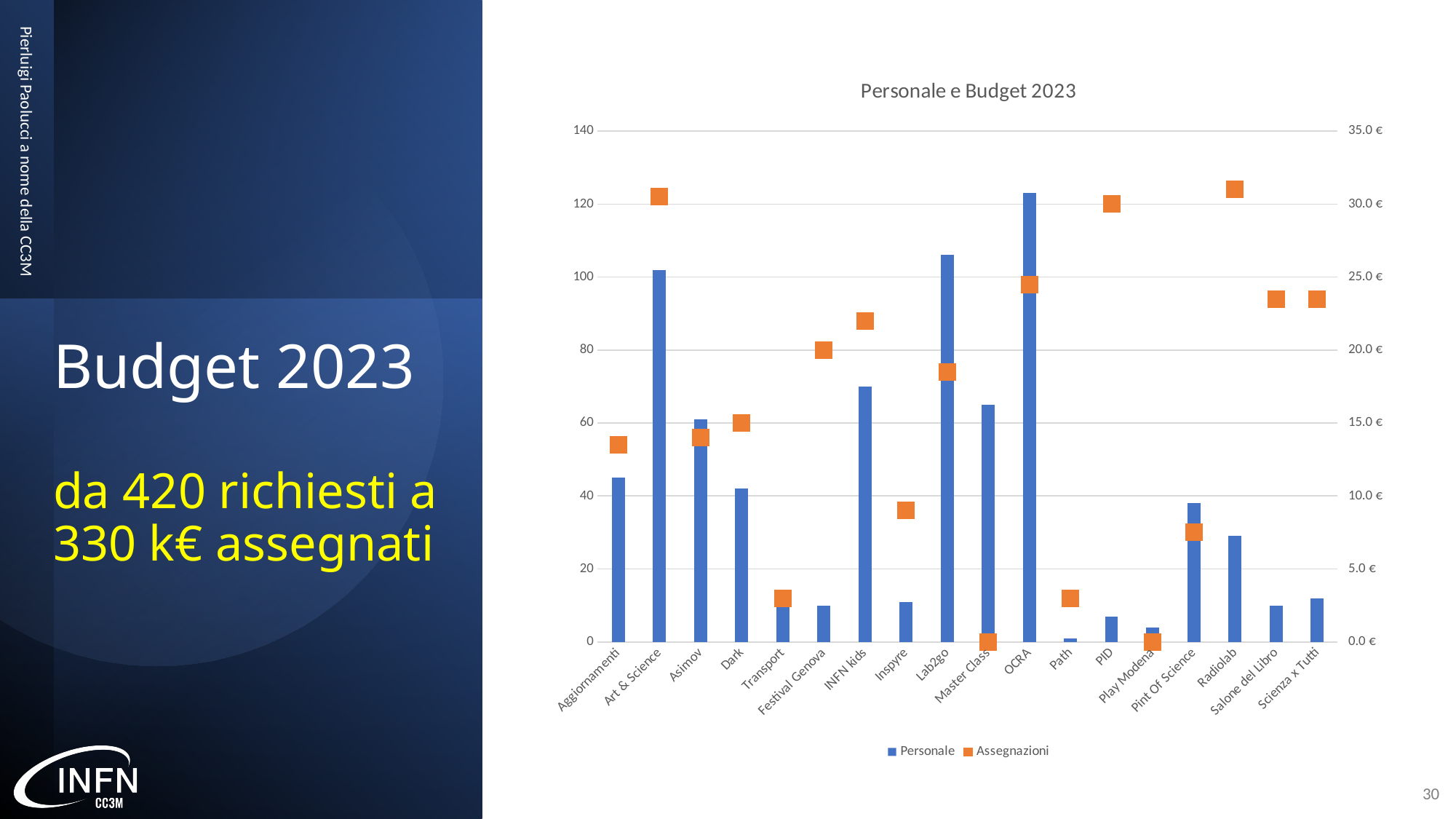
How many series does the chart legend list? 2 Is the Assegnazioni value for Inspyre greater or less than 10.0 €? less What are the two series named in the legend? Personale and Assegnazioni Which category has the highest Personale bar? OCRA Which category has the lowest Personale bar? Path Is the Personale value for Radiolab greater or less than 40? less Is the Personale value for INFN kids greater or less than 60? greater Which has the larger Personale value, OCRA or Lab2go? OCRA Which has the larger Assegnazioni value, Art & Science or Aggiornamenti? Art & Science What is the title of the chart? Personale e Budget 2023 How many categories are shown on the x axis of the chart? 18